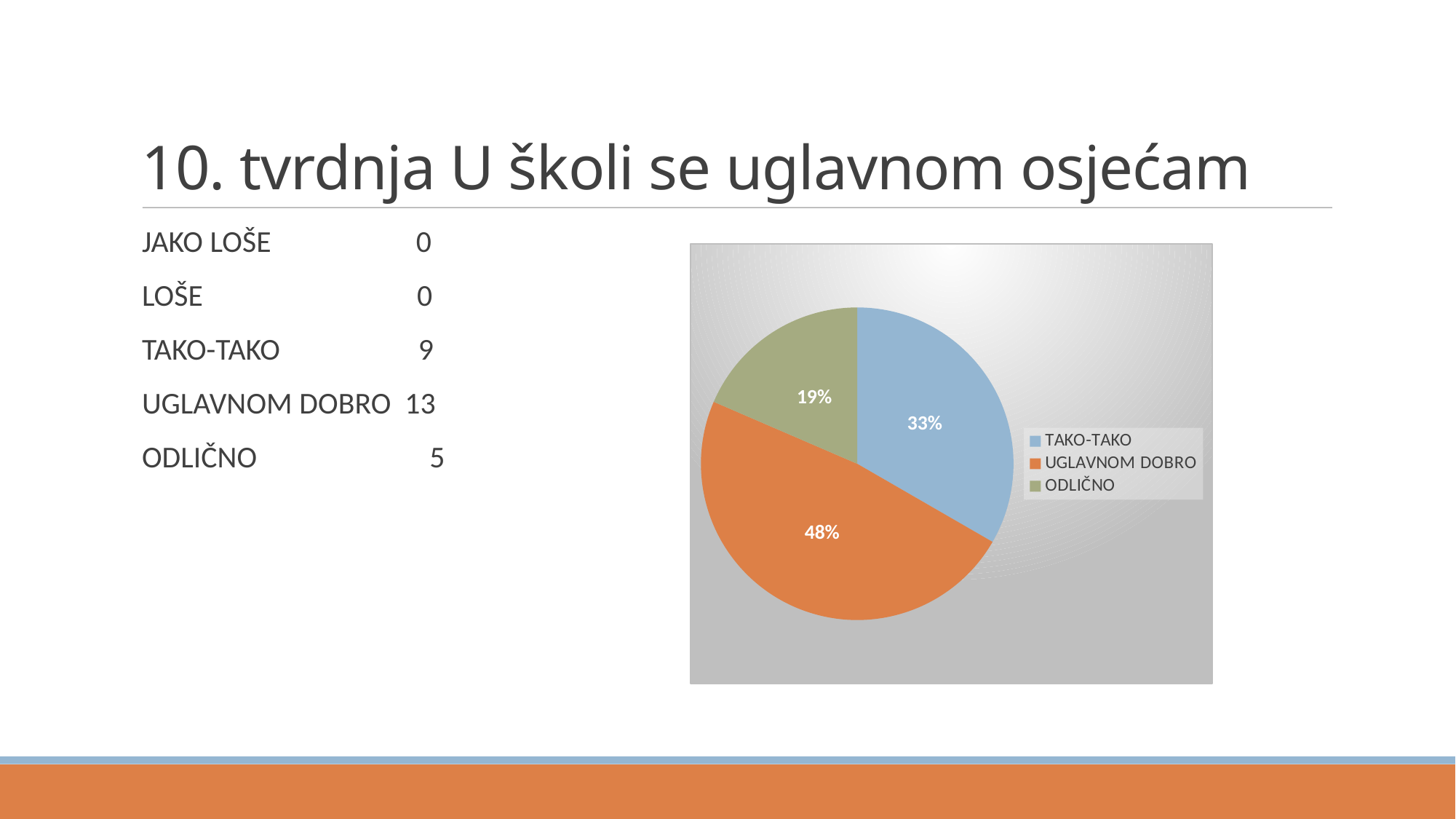
What percentage of the pie does the UGLAVNOM DOBRO slice represent? 48% What is the difference in percentage points between the UGLAVNOM DOBRO slice and the TAKO-TAKO slice? 15% Which slice is larger, TAKO-TAKO or ODLIČNO? TAKO-TAKO Which legend entry is shown in blue? TAKO-TAKO Which category has the smallest slice of the pie? ODLIČNO What colour is the UGLAVNOM DOBRO slice in the pie chart? orange Which category has the largest slice of the pie? UGLAVNOM DOBRO How many entries does the legend list? 3 What kind of chart is shown on the slide? pie chart What percentage of the pie does the ODLIČNO slice represent? 19% How many slices does the pie chart have? 3 What percentage of the pie does the TAKO-TAKO slice represent? 33%